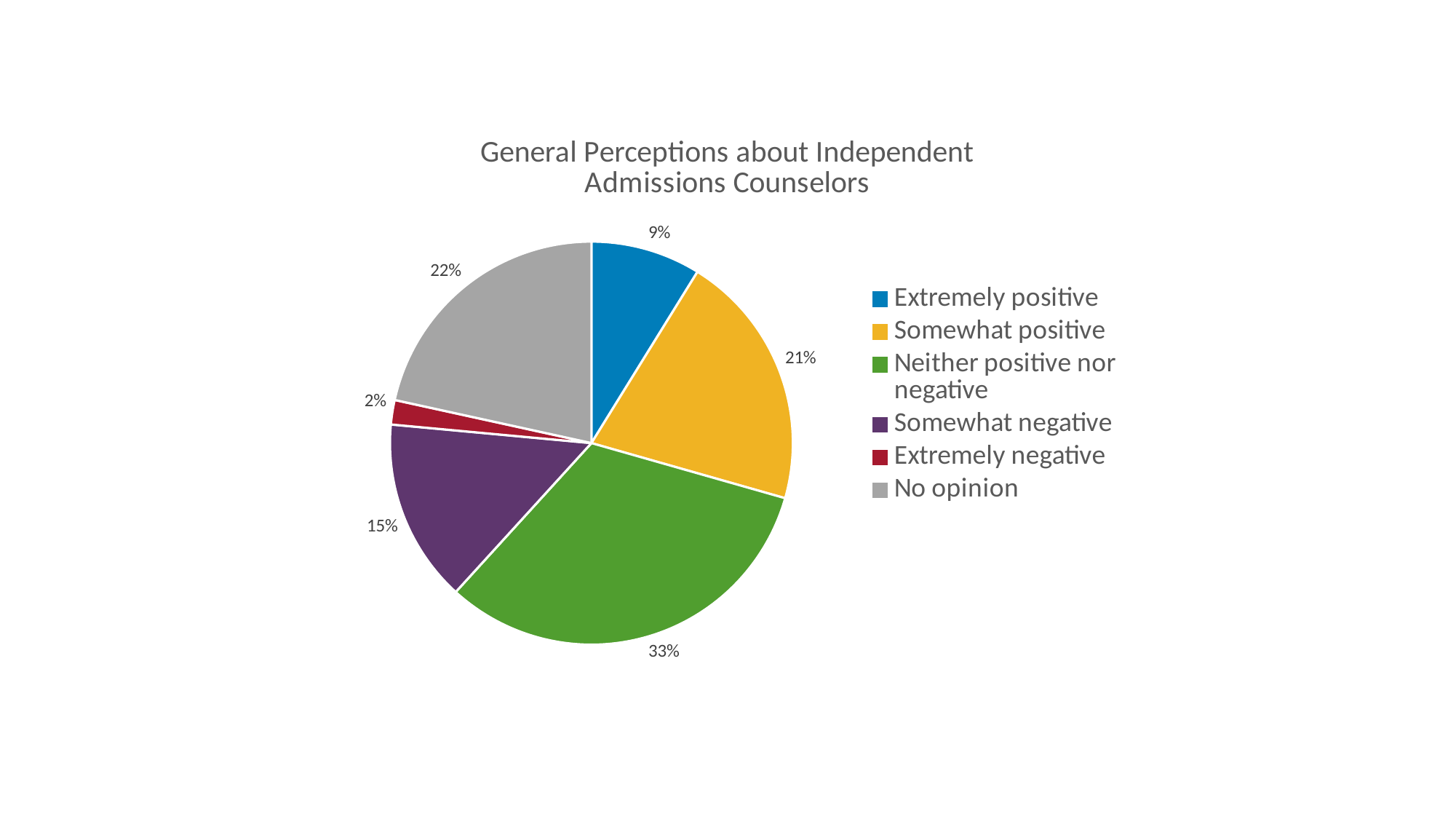
What share of the pie is 'Neither positive nor negative'? 33% What is the value for 'Somewhat negative'? 15% What is the difference between 'Somewhat positive' and 'Extremely positive'? 12% What colour is the 'Somewhat positive' slice? yellow What is the value for 'Extremely positive'? 9% Which category has the largest slice? Neither positive nor negative What is the value for 'No opinion'? 22% What is the title of the chart? General Perceptions about Independent Admissions Counselors Which category has the smallest slice? Extremely negative Which is larger, 'No opinion' or 'Somewhat positive'? No opinion What kind of chart is shown on the slide? pie chart How many categories does the pie chart have? 6